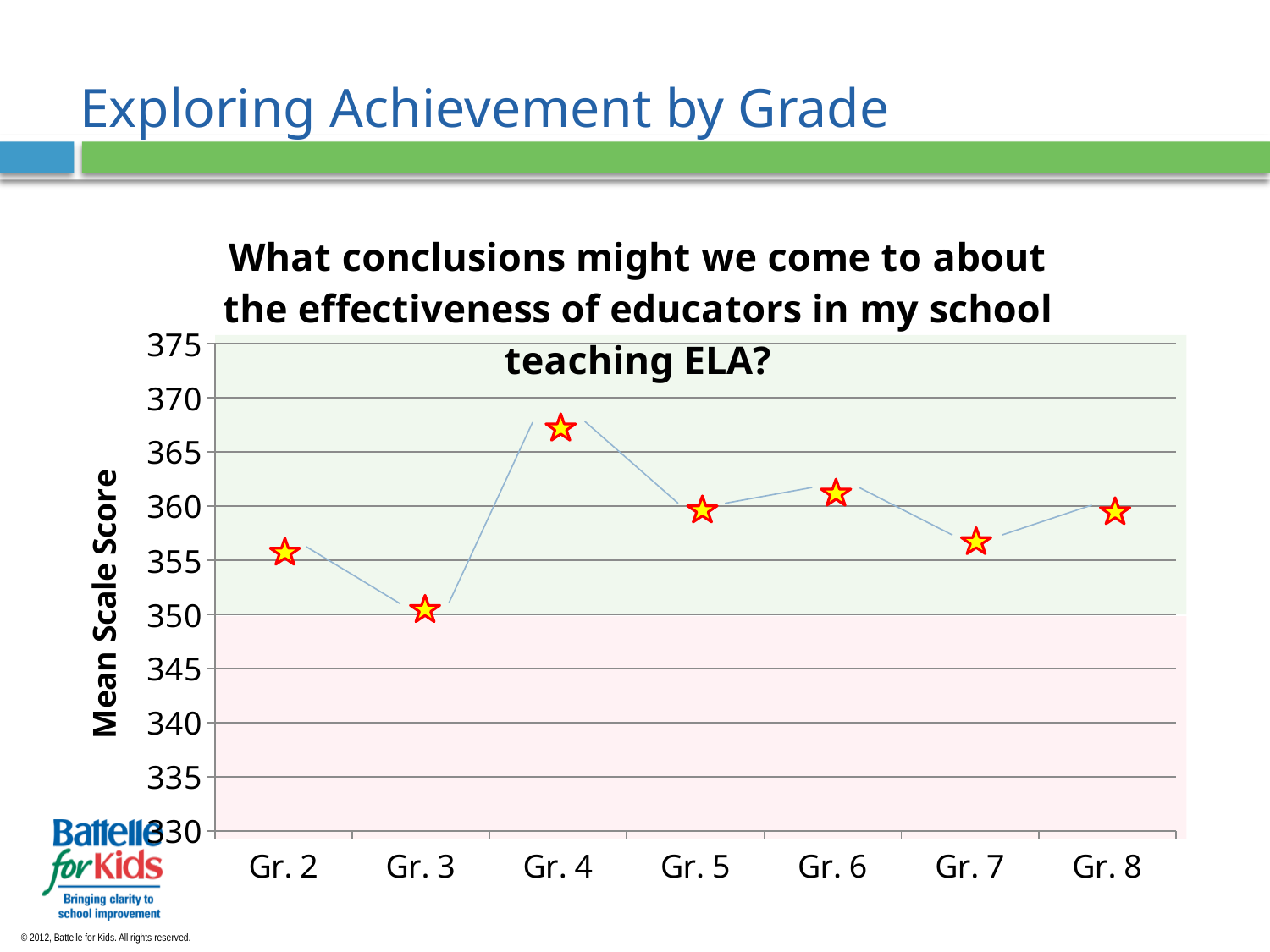
Is the value for Gr. 4 greater or less than 365? greater Which grade has the lowest mean scale score? Gr. 3 Which has the larger mean scale score, Gr. 6 or Gr. 3? Gr. 6 What is the label on the y axis of the chart? Mean Scale Score Is the value for Gr. 2 greater or less than 360? less How many grade levels are plotted on the x axis? 7 Is the value for Gr. 7 greater or less than 360? less Which has the larger mean scale score, Gr. 4 or Gr. 3? Gr. 4 Does the mean scale score rise or fall from Gr. 3 to Gr. 4? rise What kind of chart is shown on the slide? line chart Which grade has the highest mean scale score? Gr. 4